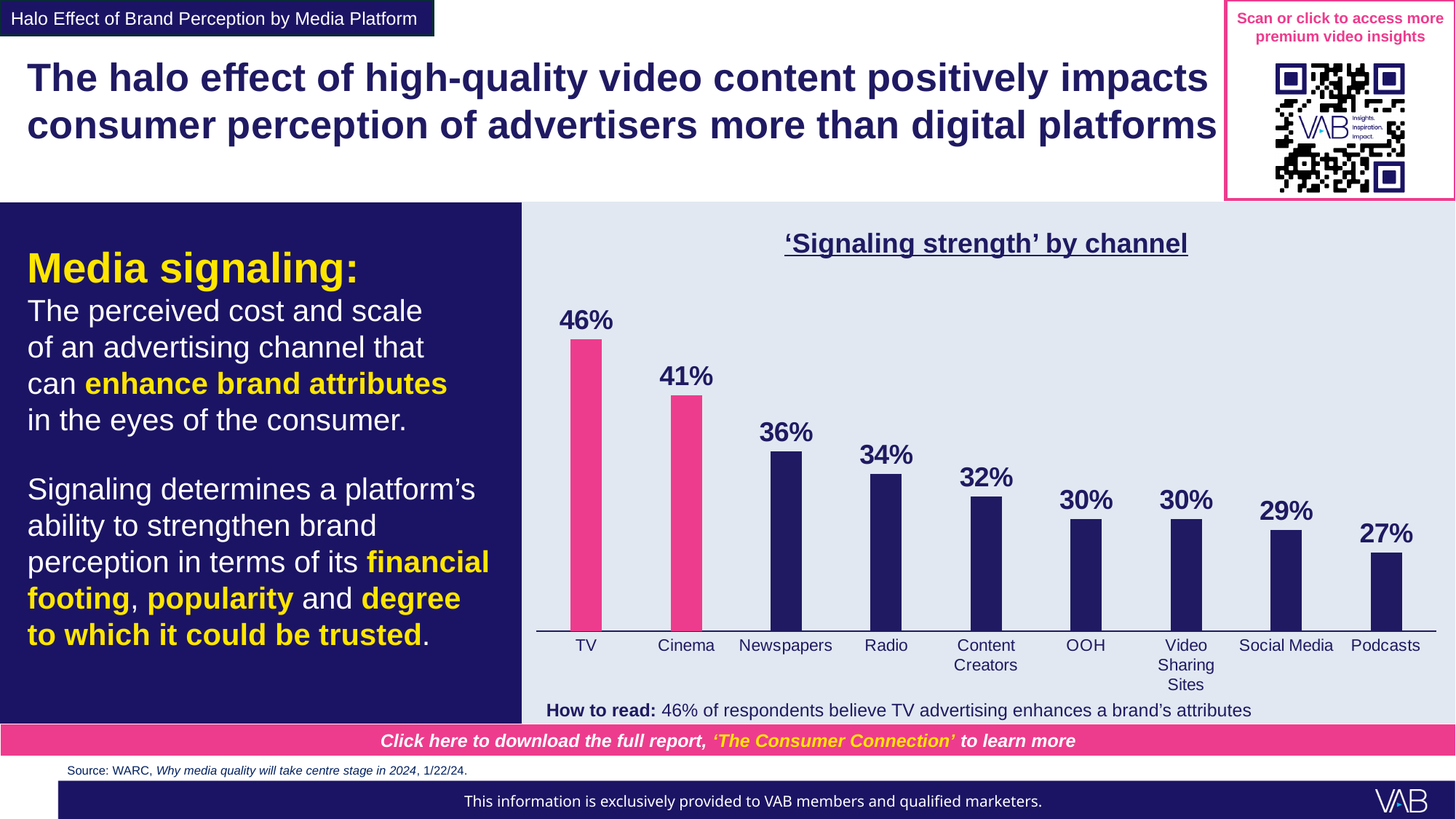
Which two channels are shown with pink bars? TV and Cinema What is the signaling strength value for TV? 46% How many channels are shown in the chart? 9 Which has a higher signaling strength, Radio or Content Creators? Radio What is the signaling strength value for Podcasts? 27% What kind of chart is used to show signaling strength by channel? Bar chart Which channel has the lowest signaling strength? Podcasts Which channel has the highest signaling strength? TV What is the difference between the signaling strength of Newspapers and Social Media? 7% What is the signaling strength value for Cinema? 41% What is the difference between the signaling strength of TV and Cinema? 5% What is the signaling strength value for Radio? 34%